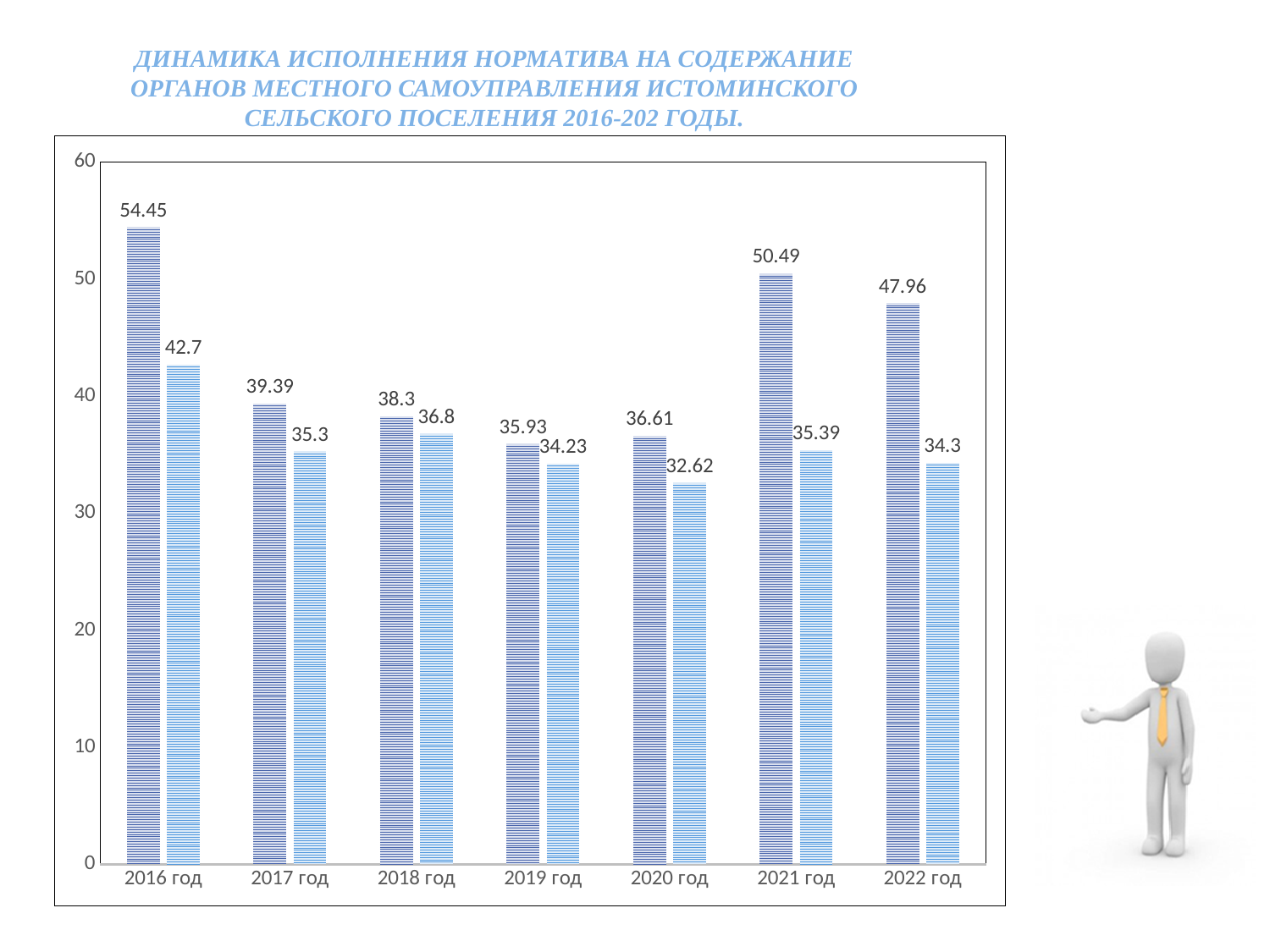
Which year has the highest darker blue bar? 2016 год What kind of chart is shown on the slide? bar chart What is the value of the lighter blue bar for 2020 год? 32.62 Which year has the lowest lighter blue bar? 2020 год Which is larger for 2018 год: the darker blue bar or the lighter blue bar? the darker blue bar Is the value of the darker blue bar for 2022 год greater or less than 40? greater How many years are shown on the x axis? 7 What is the value of the lighter blue bar for 2022 год? 34.3 Does the darker blue bar rise or fall from 2016 год to 2019 год? fall What is the value of the darker blue bar for 2021 год? 50.49 What is the difference between the darker blue bar and the lighter blue bar for 2016 год? 11.75 What is the value of the darker blue bar for 2016 год? 54.45